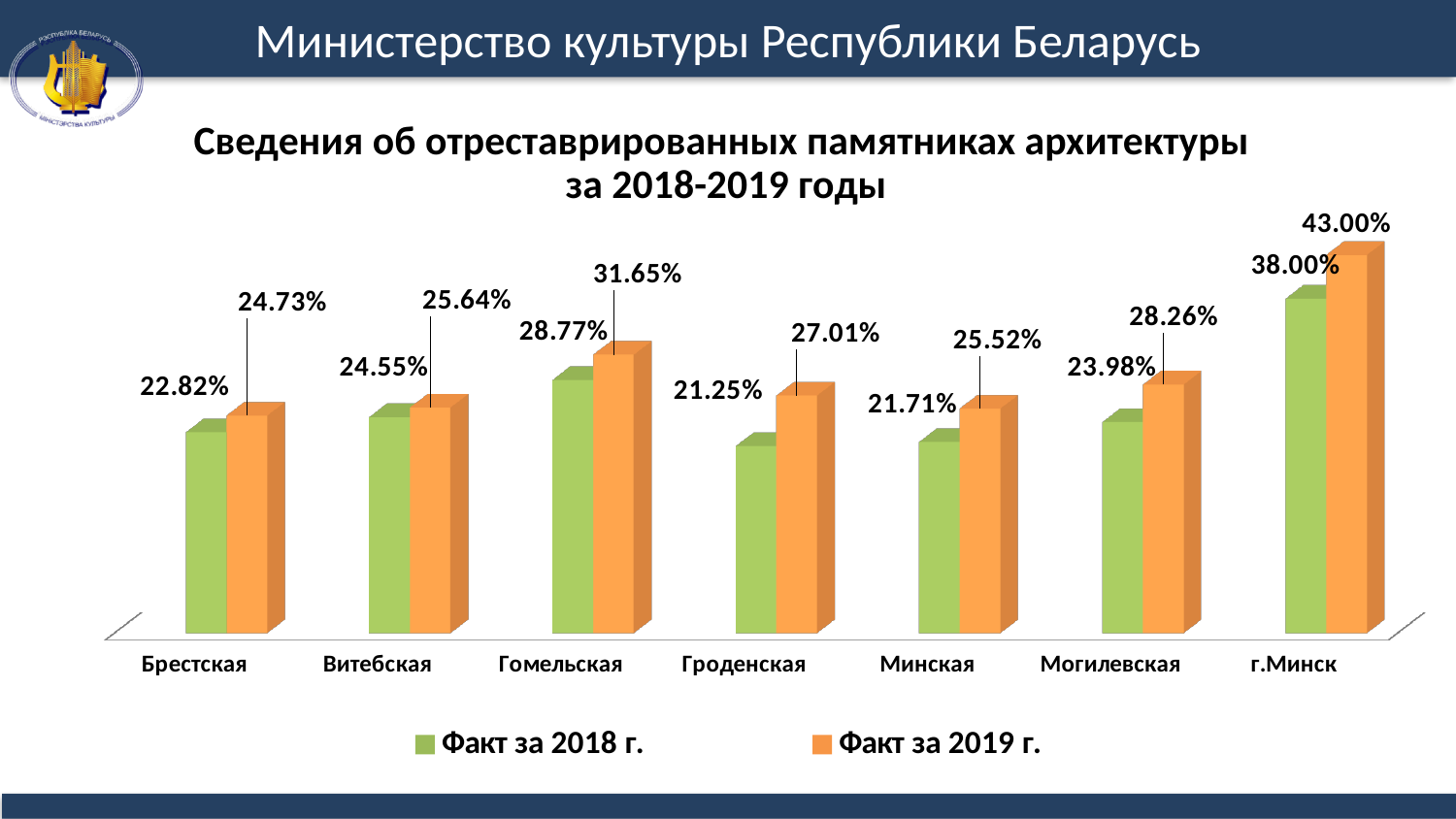
What is the value for Могилевская in the series Факт за 2019 г.? 28.26% What is the difference between the Факт за 2019 г. and Факт за 2018 г. values for Гроденская? 5.76% Which colour represents the series Факт за 2019 г.? Orange How many series does the legend list? 2 Which category has the lowest value in the series Факт за 2018 г.? Гроденская How many categories are shown on the x axis? 7 Which category has the highest value in the series Факт за 2019 г.? г.Минск What is the difference between the Факт за 2019 г. and Факт за 2018 г. values for г.Минск? 5.00% What is the value for Гроденская in the series Факт за 2018 г.? 21.25% What is the value for Гомельская in the series Факт за 2019 г.? 31.65% What kind of chart is shown on the slide? Bar chart Which is larger: the Факт за 2018 г. value for Витебская or the Факт за 2018 г. value for Минская? Витебская